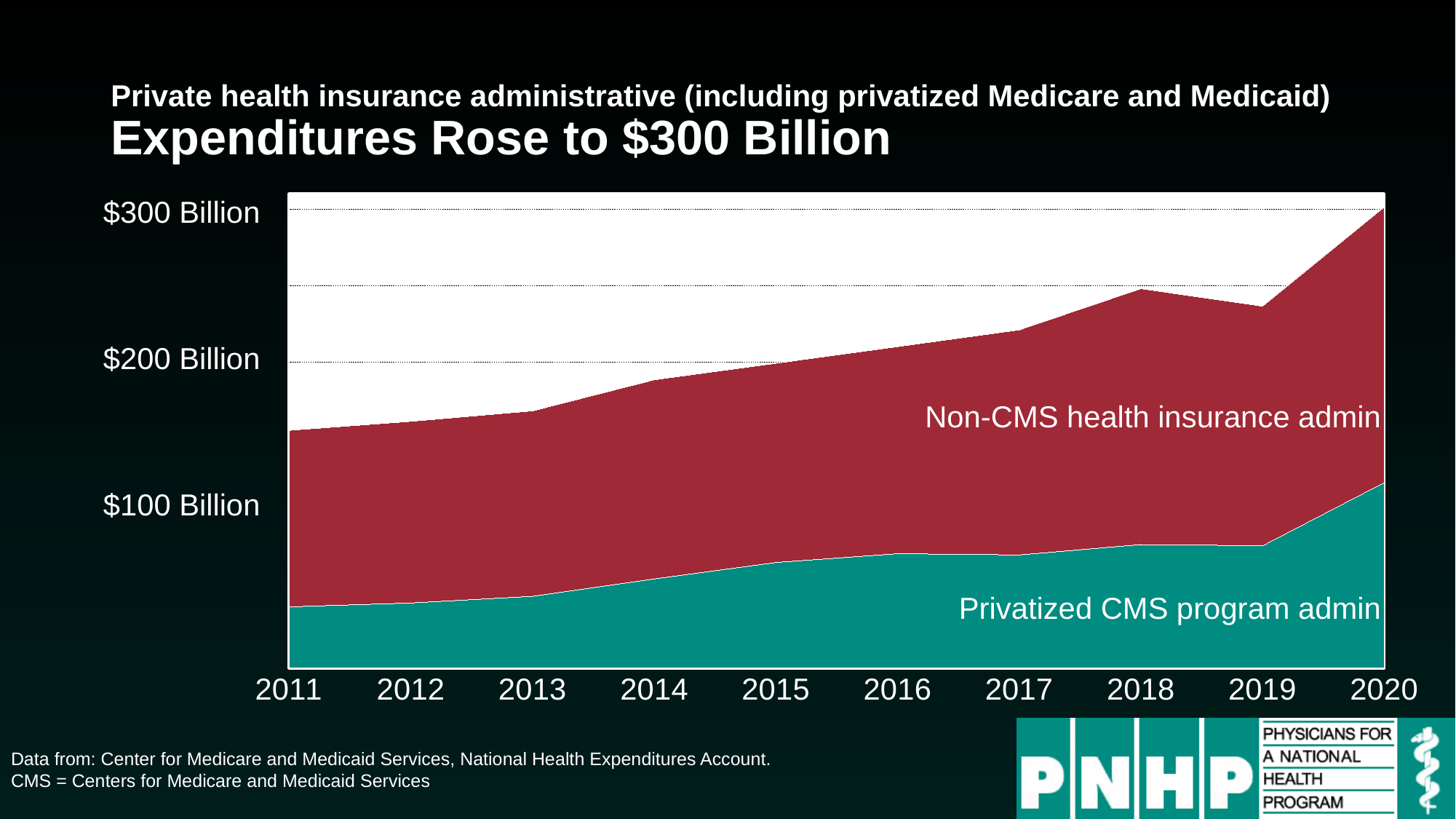
Do total expenditures generally rise or fall from 2011 to 2020? Rise How many series are plotted in the chart? 2 Is the total expenditure in 2011 greater or less than $200 Billion? less How many years are shown along the x axis of the chart? 10 What kind of chart is shown on the slide? Area chart In which year is the total expenditure lowest? 2011 Is the value for Privatized CMS program admin in 2020 greater or less than $100 Billion? greater Which is larger, the total expenditure in 2018 or in 2019? 2018 Is the total expenditure in 2020 greater or less than $200 Billion? greater Which two series are labeled in the chart? Non-CMS health insurance admin and Privatized CMS program admin In which year is the total expenditure highest? 2020